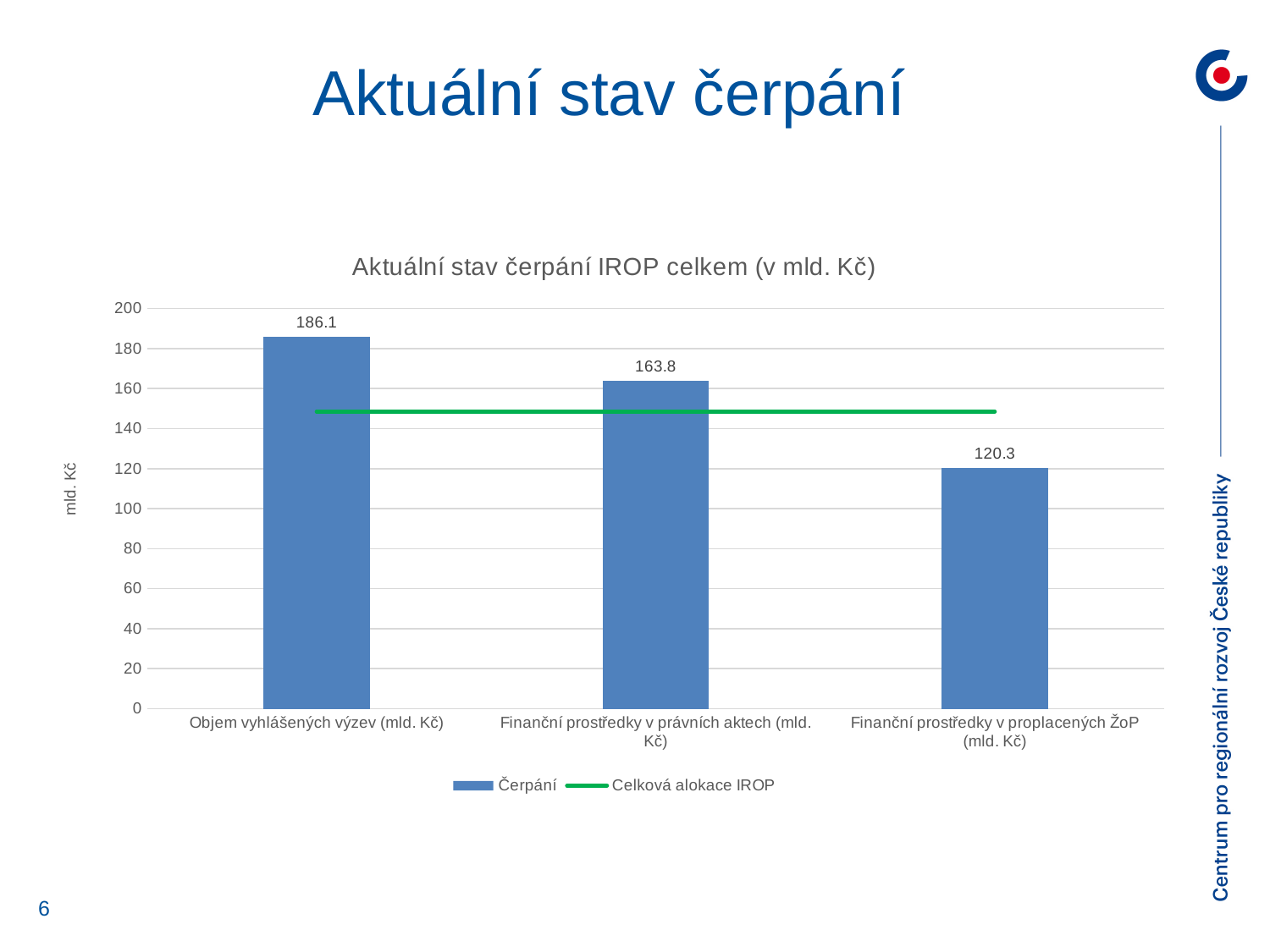
What is the value for Objem vyhlášených výzev (mld. Kč)? 186.1 What kind of chart is this? combination bar and line chart What is the difference between Objem vyhlášených výzev and Finanční prostředky v proplacených ŽoP? 65.8 Which category has the highest value? Objem vyhlášených výzev (mld. Kč) Do the bar values rise or fall from left to right? fall What is the value for Finanční prostředky v právních aktech (mld. Kč)? 163.8 Is the Celková alokace IROP line greater or less than 140? greater Which is larger: Finanční prostředky v právních aktech or Finanční prostředky v proplacených ŽoP? Finanční prostředky v právních aktech (mld. Kč) What is the value for Finanční prostředky v proplacených ŽoP (mld. Kč)? 120.3 Which category has the lowest value? Finanční prostředky v proplacených ŽoP (mld. Kč) How many series does the legend list? 2 How many categories are shown on the x axis? 3